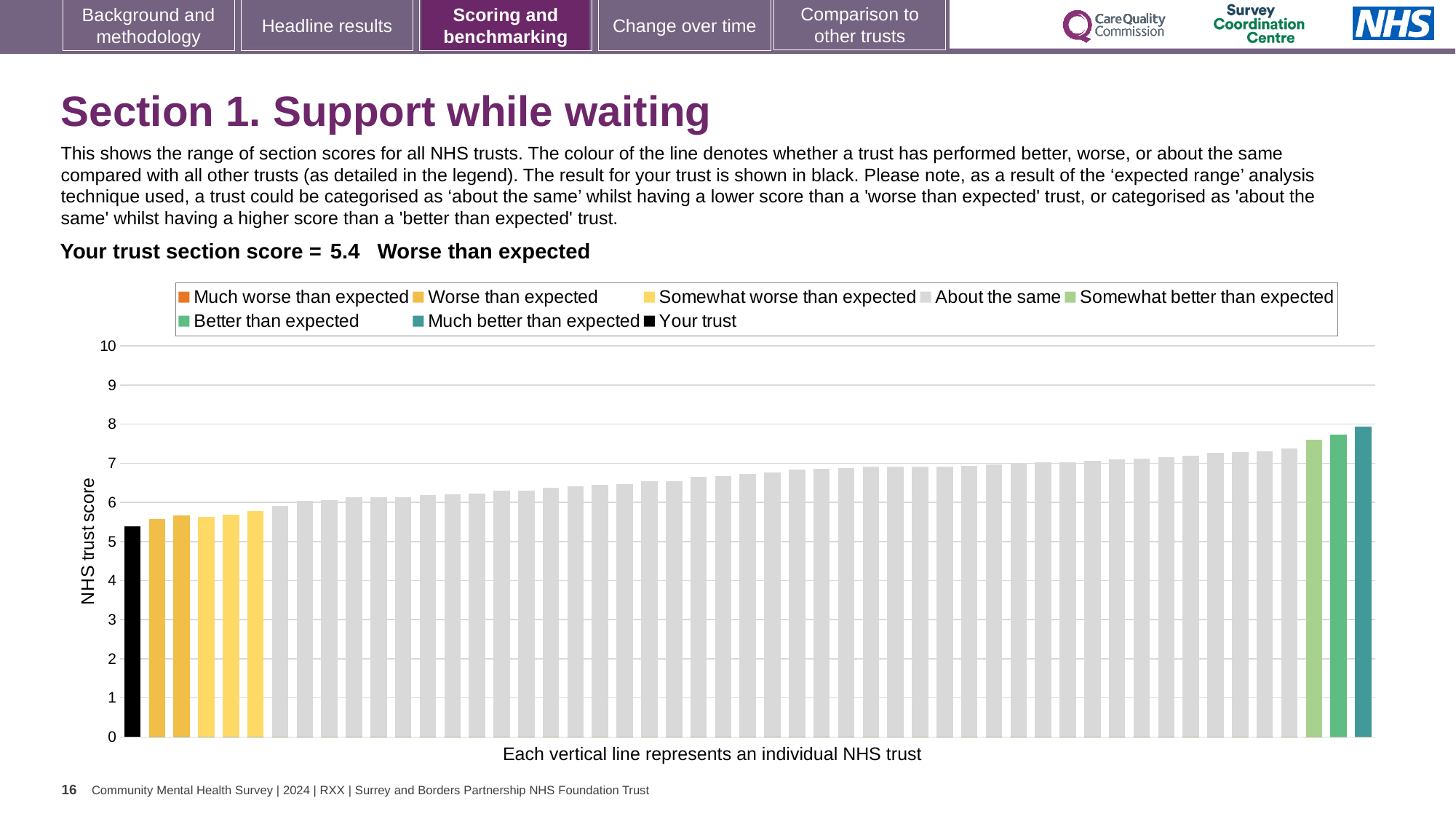
How many entries does the chart legend list? 8 Which bar has the lowest score in the chart? Your trust (the black bar) How many bars are coloured as 'Much better than expected'? 1 Do the bar values rise or fall from left to right along the x axis? rise Which legend category does the tallest bar belong to? Much better than expected Is the value of the black 'Your trust' bar greater or less than 6? less What kind of chart is shown on the slide? bar chart Which performance category is your trust placed in for this section? Worse than expected What is the label on the y axis of the chart? NHS trust score Is the value of the tallest bar greater or less than 7? greater What is the section score for your trust? 5.4 How many bars are coloured as 'Worse than expected'? 2